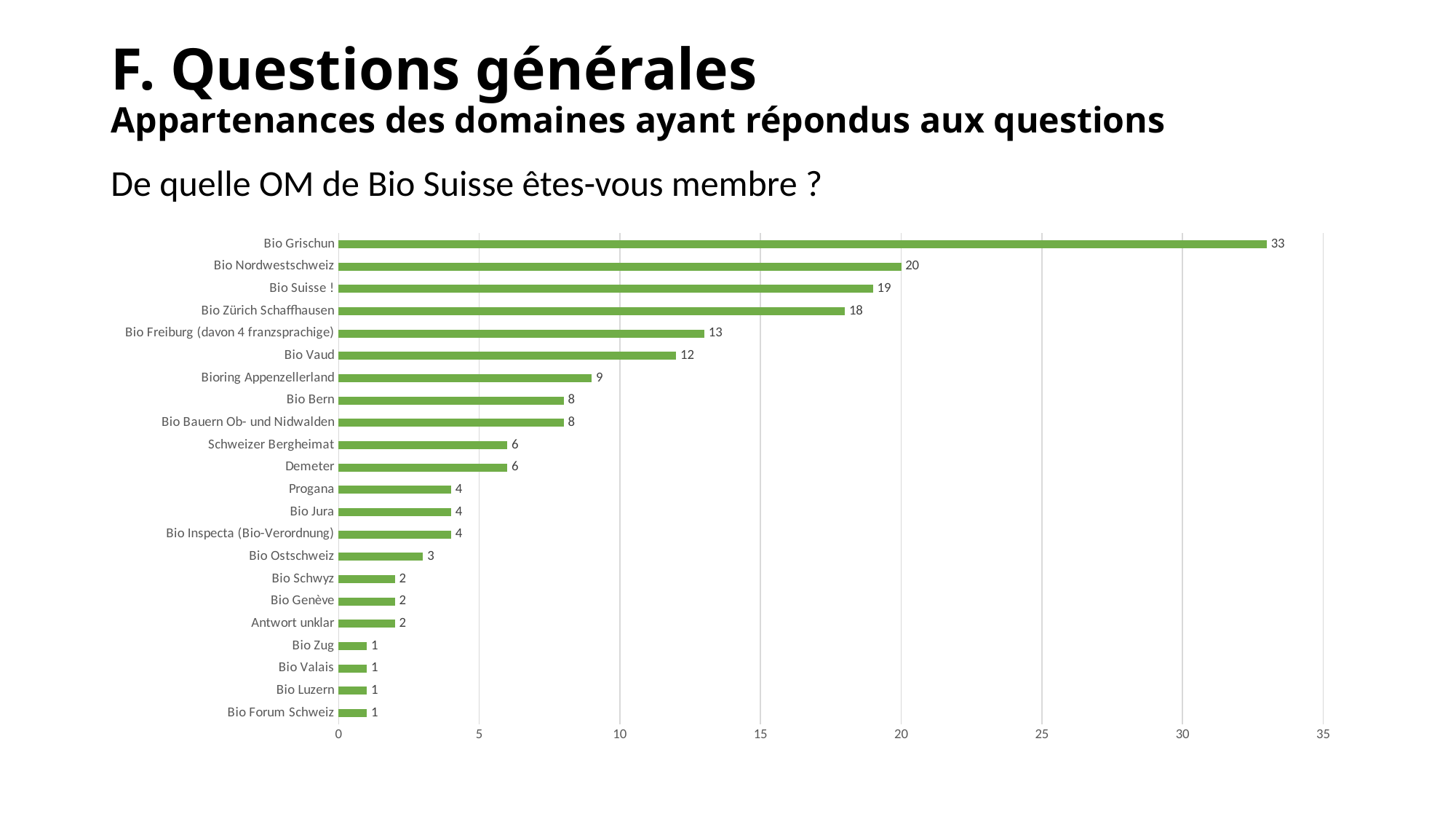
How many categories are shown in the chart? 22 What is the difference between the values for Bio Grischun and Bio Nordwestschweiz? 13 What is the value for Bio Grischun? 33 What is the value for Bio Zürich Schaffhausen? 18 What is the difference between the values for Bio Freiburg (davon 4 franzsprachige) and Bio Vaud? 1 What is the value for Bioring Appenzellerland? 9 Which is larger, the value for Bio Suisse ! or the value for Bio Bern? Bio Suisse ! What is the value for Bio Ostschweiz? 3 Is the value for Bio Nordwestschweiz greater or less than 15? greater What kind of chart is shown on the slide? bar chart Which category has the highest value? Bio Grischun What is the maximum value shown on the horizontal axis? 35